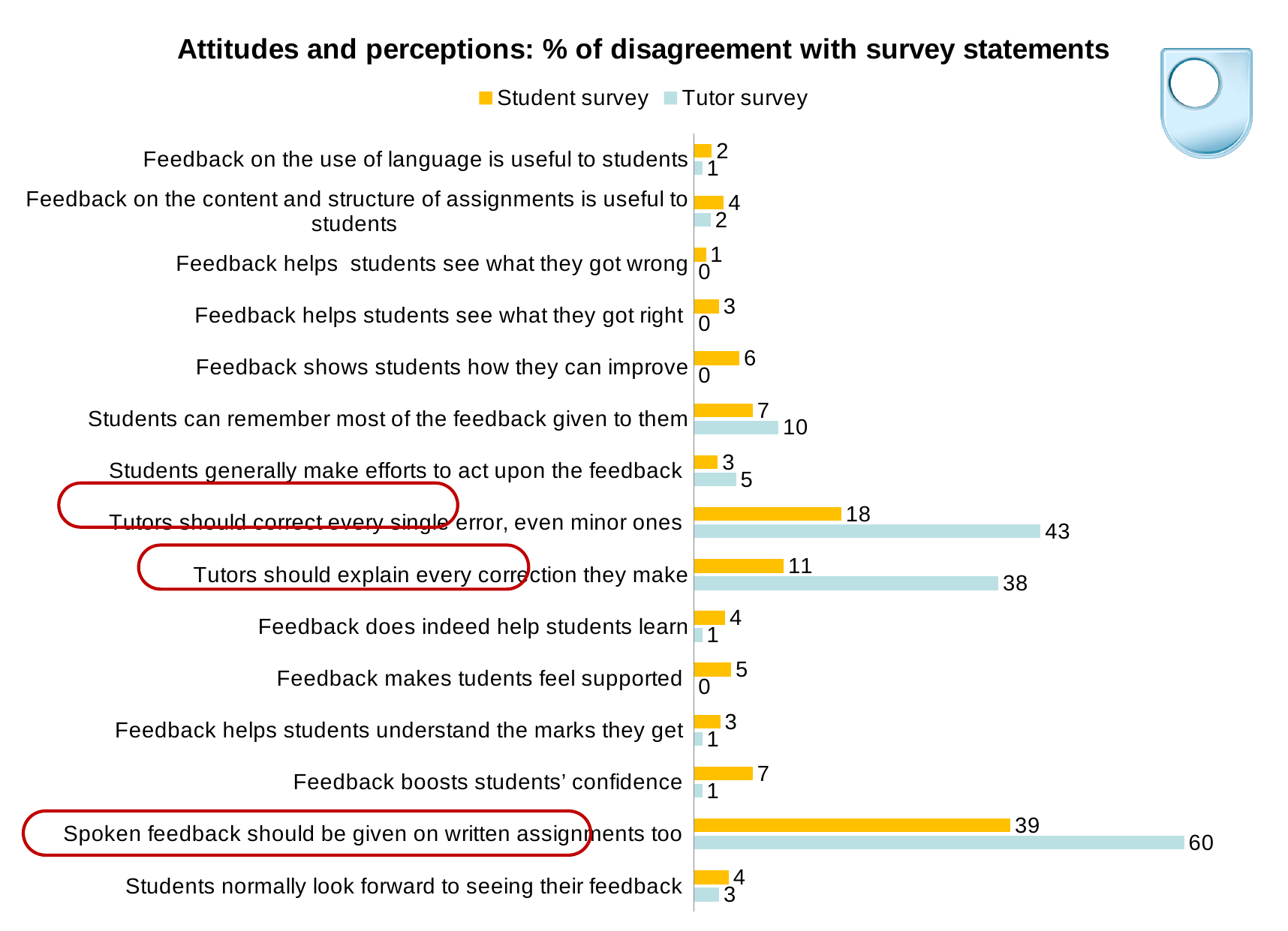
What kind of chart is shown on the slide? Bar chart Which statement has the highest Tutor survey value? Spoken feedback should be given on written assignments too For "Students generally make efforts to act upon the feedback", which is larger: the Student survey value or the Tutor survey value? Tutor survey What is the title of the chart? Attitudes and perceptions: % of disagreement with survey statements What is the difference between the Tutor survey and Student survey values for "Tutors should explain every correction they make"? 27 Which statement has the highest Student survey value? Spoken feedback should be given on written assignments too What is the Tutor survey value for "Spoken feedback should be given on written assignments too"? 60 How many series does the legend list? 2 How many survey statements are listed on the chart? 15 What is the Tutor survey value for "Students can remember most of the feedback given to them"? 10 Which colour represents the Student survey series? Orange What is the Student survey value for "Tutors should correct every single error, even minor ones"? 18